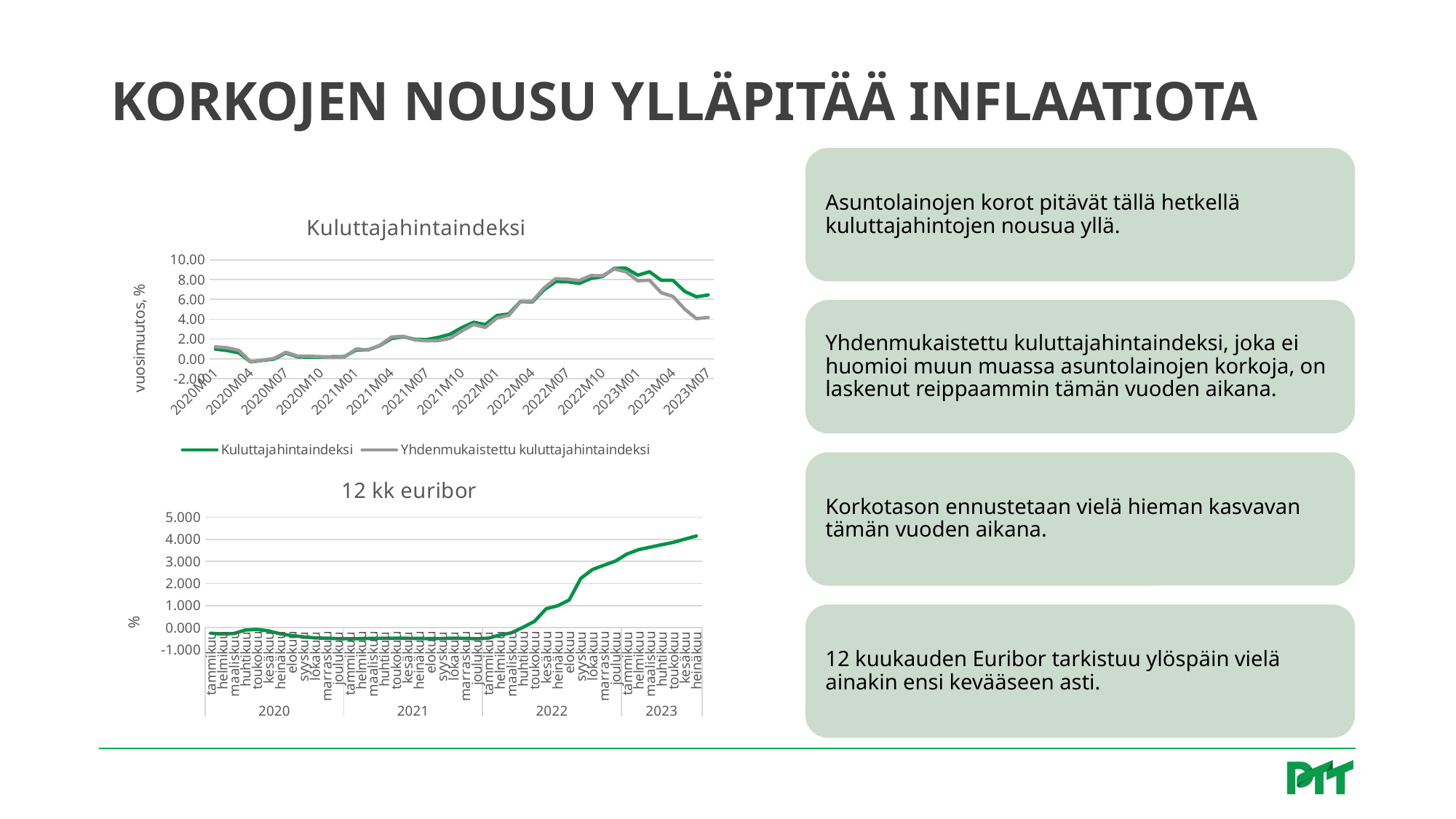
In the 'Kuluttajahintaindeksi' chart, which series is drawn in green? Kuluttajahintaindeksi What kind of chart is the 'Kuluttajahintaindeksi' chart? line chart What is the y-axis label of the 'Kuluttajahintaindeksi' chart? vuosimuutos, % In the 'Kuluttajahintaindeksi' chart, is the value of the Kuluttajahintaindeksi series at 2023M07 greater or less than 4.00? greater In the 'Kuluttajahintaindeksi' chart, is the peak value of the Kuluttajahintaindeksi series around 2023M01 greater or less than 8.00? greater How many series does the legend of the 'Kuluttajahintaindeksi' chart list? 2 What kind of chart is the '12 kk euribor' chart? line chart In the 'Kuluttajahintaindeksi' chart, is the value of the Yhdenmukaistettu kuluttajahintaindeksi series at 2023M07 greater or less than 6.00? less In the 'Kuluttajahintaindeksi' chart, at 2023M07, which series has the higher value: Kuluttajahintaindeksi or Yhdenmukaistettu kuluttajahintaindeksi? Kuluttajahintaindeksi How many years are labelled on the x axis of the '12 kk euribor' chart? 4 In the '12 kk euribor' chart, do the values overall rise or fall from 2020 to 2023? rise